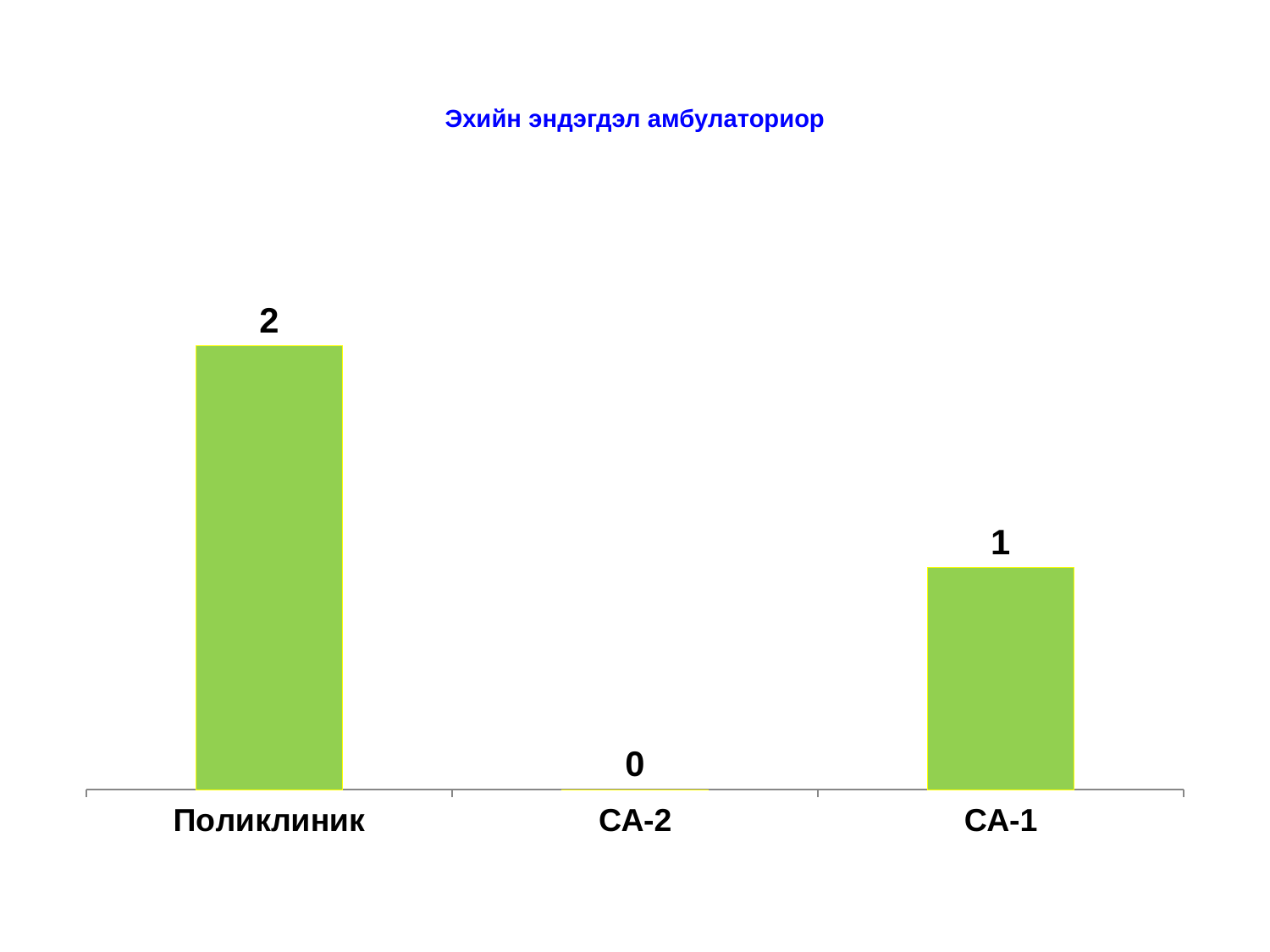
What is the value for Поликлиник? 2 What is the total of the values for Поликлиник, СА-2 and СА-1? 3 What is the value for СА-1? 1 Which is larger, the value for СА-1 or the value for СА-2? СА-1 How many categories are shown on the x axis? 3 What is the title of the chart? Эхийн эндэгдэл амбулаториор What colour are the bars in the chart? green Which category has the lowest value? СА-2 Which category has the highest value? Поликлиник What is the difference between the values for Поликлиник and СА-1? 1 What kind of chart is shown on the slide? bar chart What is the value for СА-2? 0